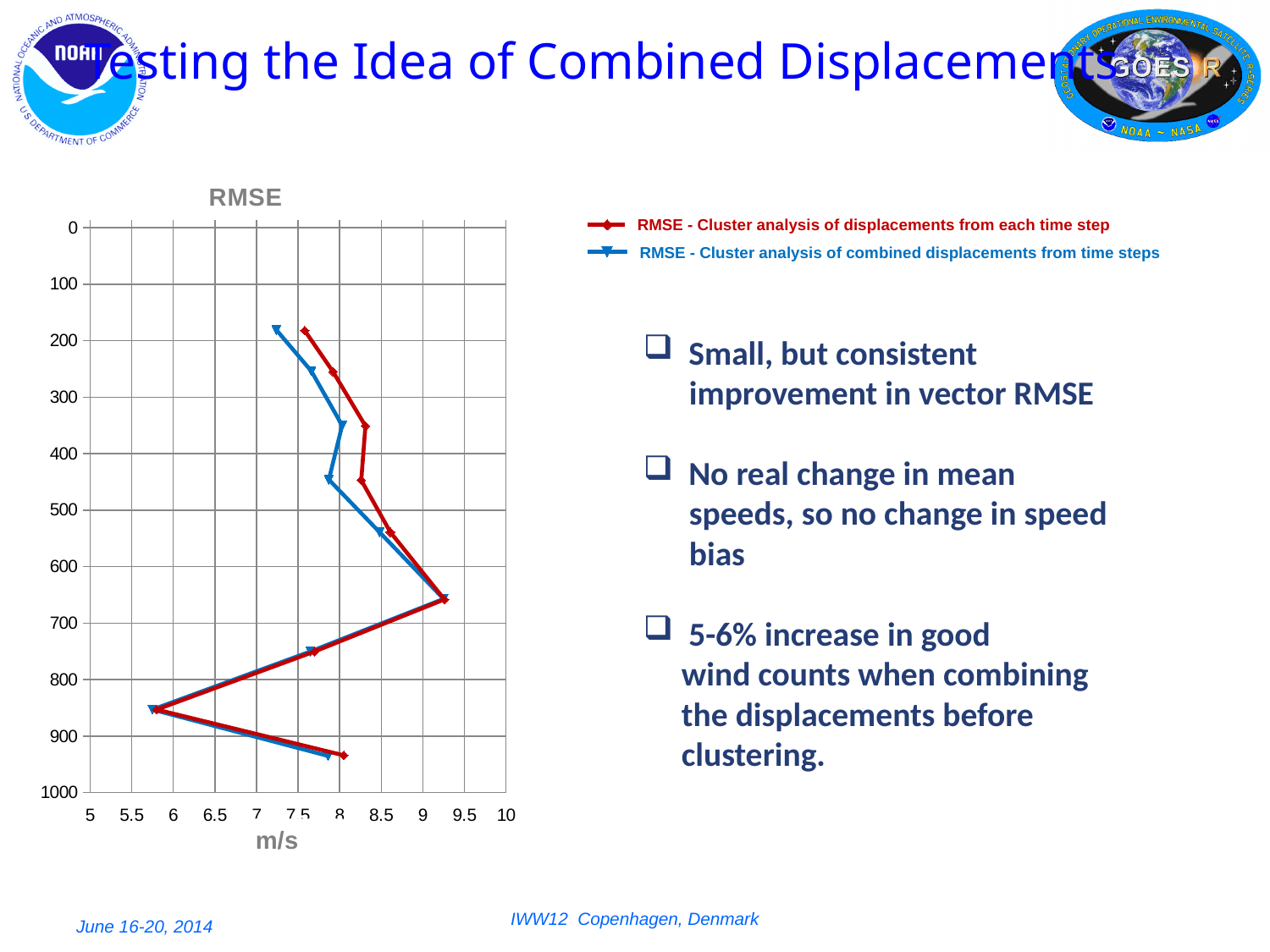
How many data points are plotted for the red series (cluster analysis of displacements from each time step)? 9 At the level between 300 and 400 on the y axis, is the RMSE of the red series (each time step) greater or less than 8 m/s? greater At the topmost plotted level (near 200 on the y axis), is the RMSE of the blue series (combined displacements) greater or less than 7.5 m/s? less At the topmost plotted level (near 200 on the y axis), which series has the higher RMSE: the red series (each time step) or the blue series (combined displacements)? the red series (each time step) At the level between 400 and 500 on the y axis, which series has the higher RMSE: the red series (each time step) or the blue series (combined displacements)? the red series (each time step) Is the lowest RMSE value of the red series (cluster analysis of displacements from each time step) greater or less than 6 m/s? less How many series does the chart's legend list? 2 What is the title of the chart? RMSE What kind of chart is shown on the slide? line chart What unit is shown on the chart's x axis label? m/s